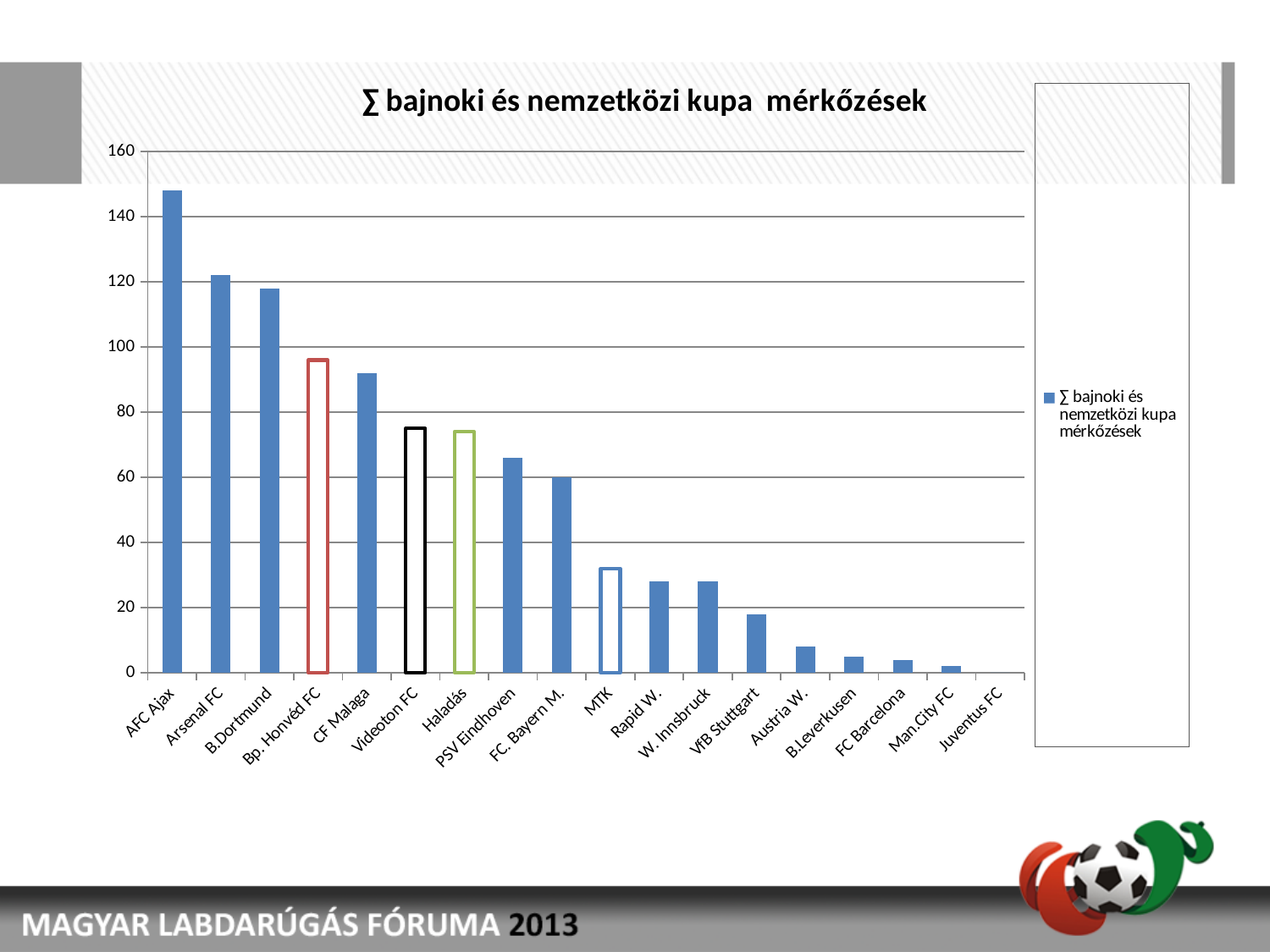
Do the values rise or fall moving from left to right along the x axis? fall How many clubs are shown on the x axis of the chart? 18 Which is larger, the value for AFC Ajax or the value for Arsenal FC? AFC Ajax Is the value for AFC Ajax greater or less than 140? greater Is the value for MTK greater or less than 40? less How many series does the legend list? 1 Is the value for Bp. Honvéd FC greater or less than 100? less Which club has the lowest value in the chart? Juventus FC What kind of chart is shown on the slide? bar chart What is the title of the chart? ∑ bajnoki és nemzetközi kupa mérkőzések Which club has the highest value in the chart? AFC Ajax